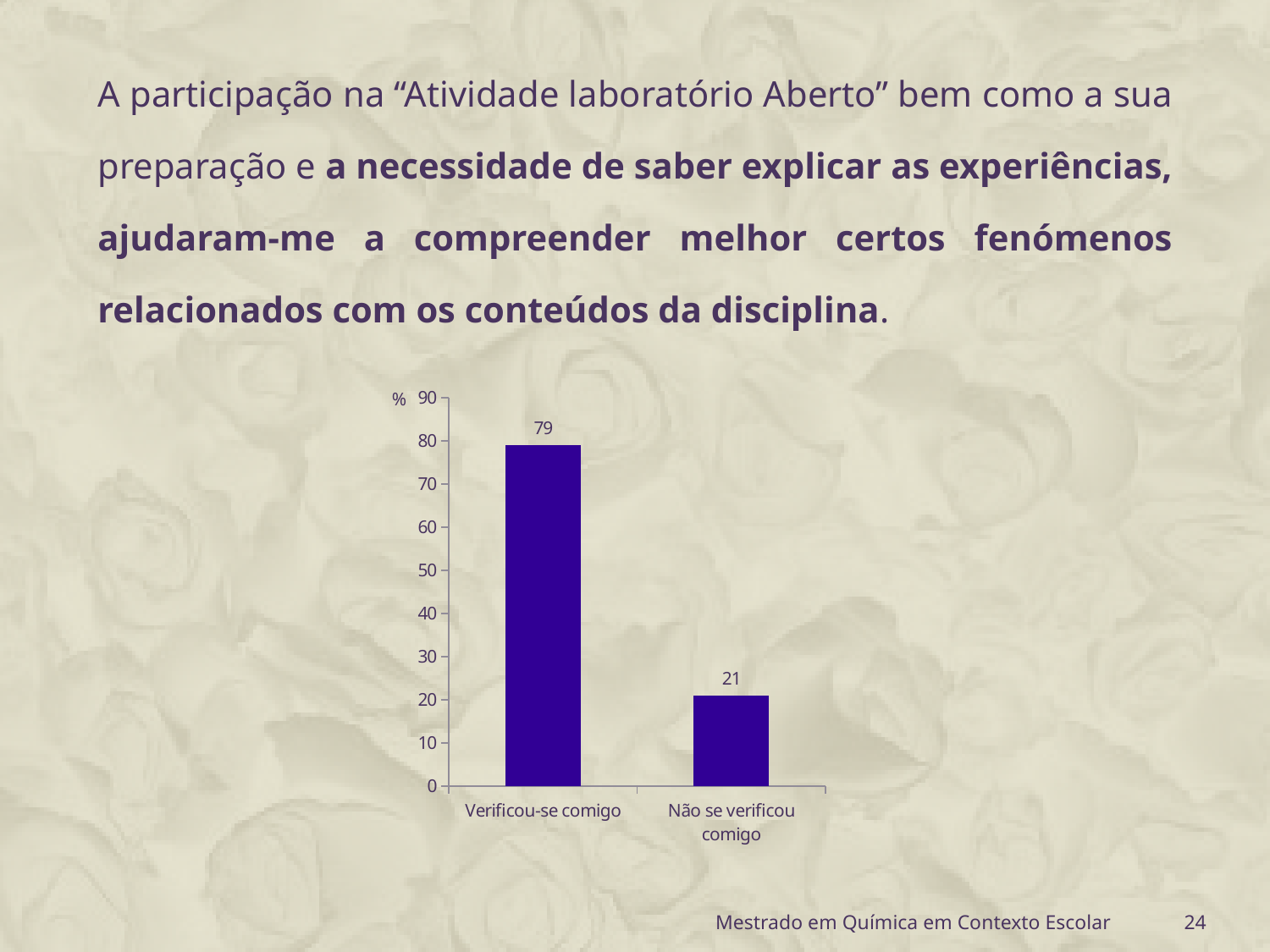
What kind of chart is shown on the slide? bar chart What is the difference between the values for "Verificou-se comigo" and "Não se verificou comigo"? 58 Is the value for "Verificou-se comigo" greater or less than 70? greater What is the value for "Não se verificou comigo"? 21 Is the value for "Não se verificou comigo" greater or less than 30? less What is the total of the two bar values? 100 Which category has the highest value? Verificou-se comigo Which is larger, the value for "Verificou-se comigo" or for "Não se verificou comigo"? Verificou-se comigo Which category has the lowest value? Não se verificou comigo What unit label is shown at the top of the vertical axis? % How many categories are shown on the x axis? 2 What is the value for "Verificou-se comigo"? 79